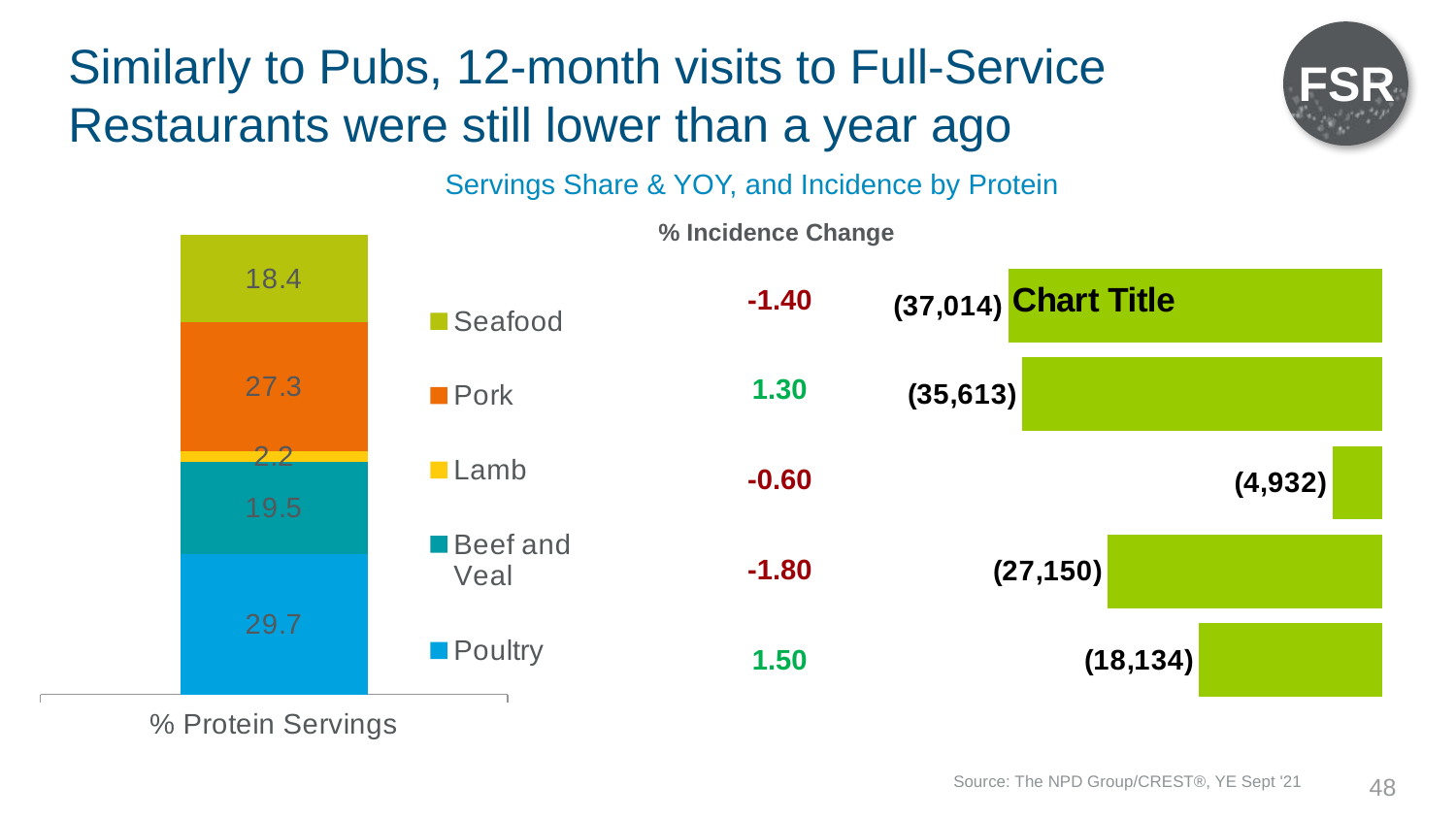
On the % Protein Servings chart, what is the value for Pork? 27.3 On the % Protein Servings chart, what is the value for Poultry? 29.7 How many series does the legend of the % Protein Servings chart list? 5 On the % Protein Servings chart, what is the difference between the Poultry and Seafood values? 11.3 On the chart on the right titled "Chart Title", what is the data label on the bottom bar? (18,134) On the % Protein Servings chart, which is larger, Beef and Veal or Seafood? Beef and Veal What kind of chart is the % Protein Servings chart? Stacked bar chart What is the total of the stacked bar on the % Protein Servings chart? 97.1 On the % Protein Servings chart, which protein has the largest share? Poultry On the % Protein Servings chart, what is the value for Lamb? 2.2 On the % Protein Servings chart, which protein has the smallest share? Lamb On the chart on the right titled "Chart Title", what is the data label on the top bar? (37,014)